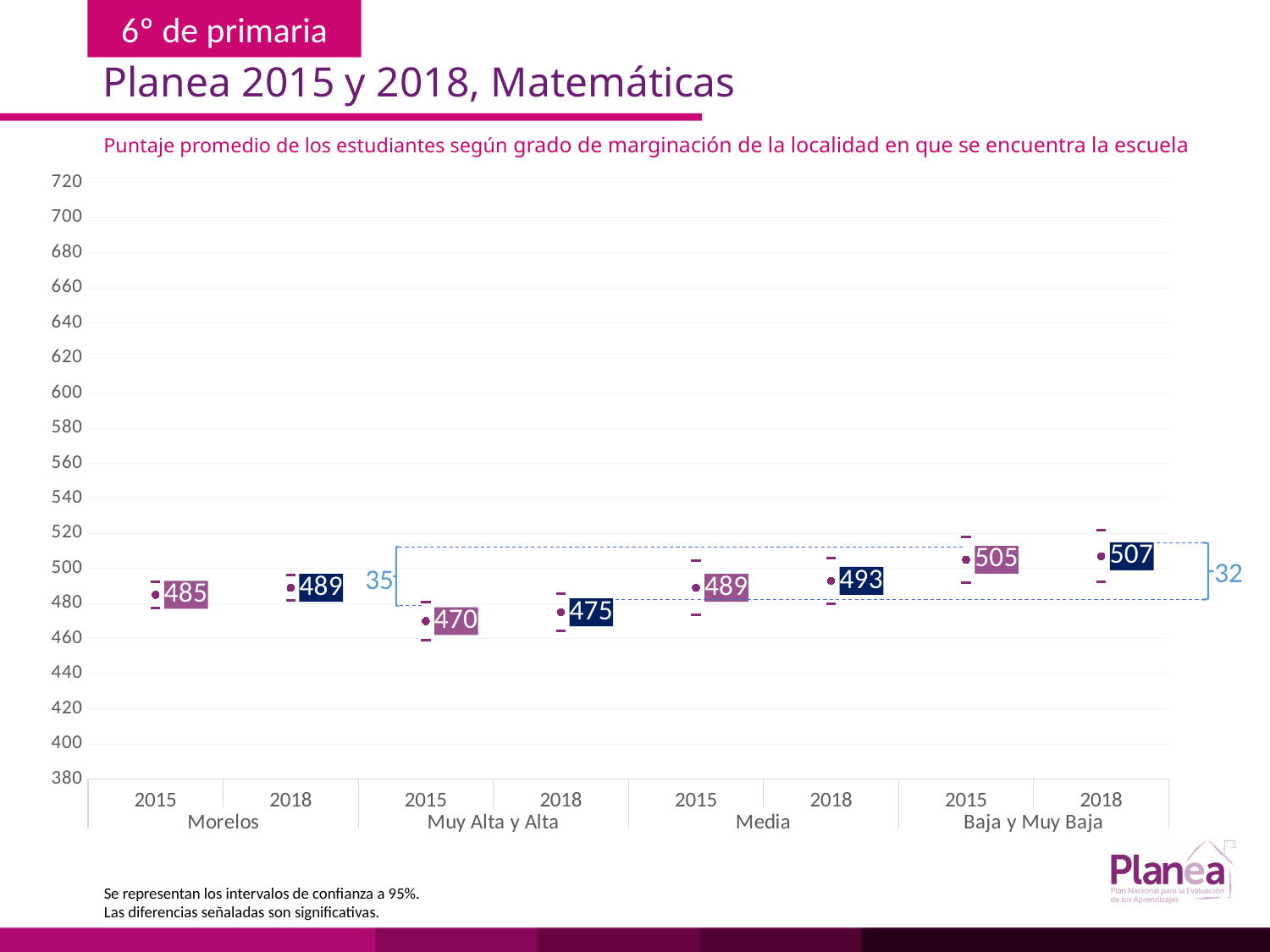
What is the difference between the 2018 and 2015 average scores for Morelos? 4 What is the 2015 average score for Morelos? 485 What is the difference between the 2015 scores of the Baja y Muy Baja group and the Muy Alta y Alta group? 35 Is the 2015 value for Muy Alta y Alta greater or less than 480? less What is the 2018 average score for the Media marginación group? 493 What is the 2015 average score for the Baja y Muy Baja marginación group? 505 Which is larger, the 2018 score for Media or the 2018 score for Morelos? Media (493) What is the 2018 average score for the Muy Alta y Alta marginación group? 475 Which group and year has the lowest average score on the chart? Muy Alta y Alta, 2015 Do the average scores rise or fall from 2015 to 2018 within each group? rise How many marginación groups (including Morelos) are shown along the x axis? 4 Which group and year has the highest average score on the chart? Baja y Muy Baja, 2018